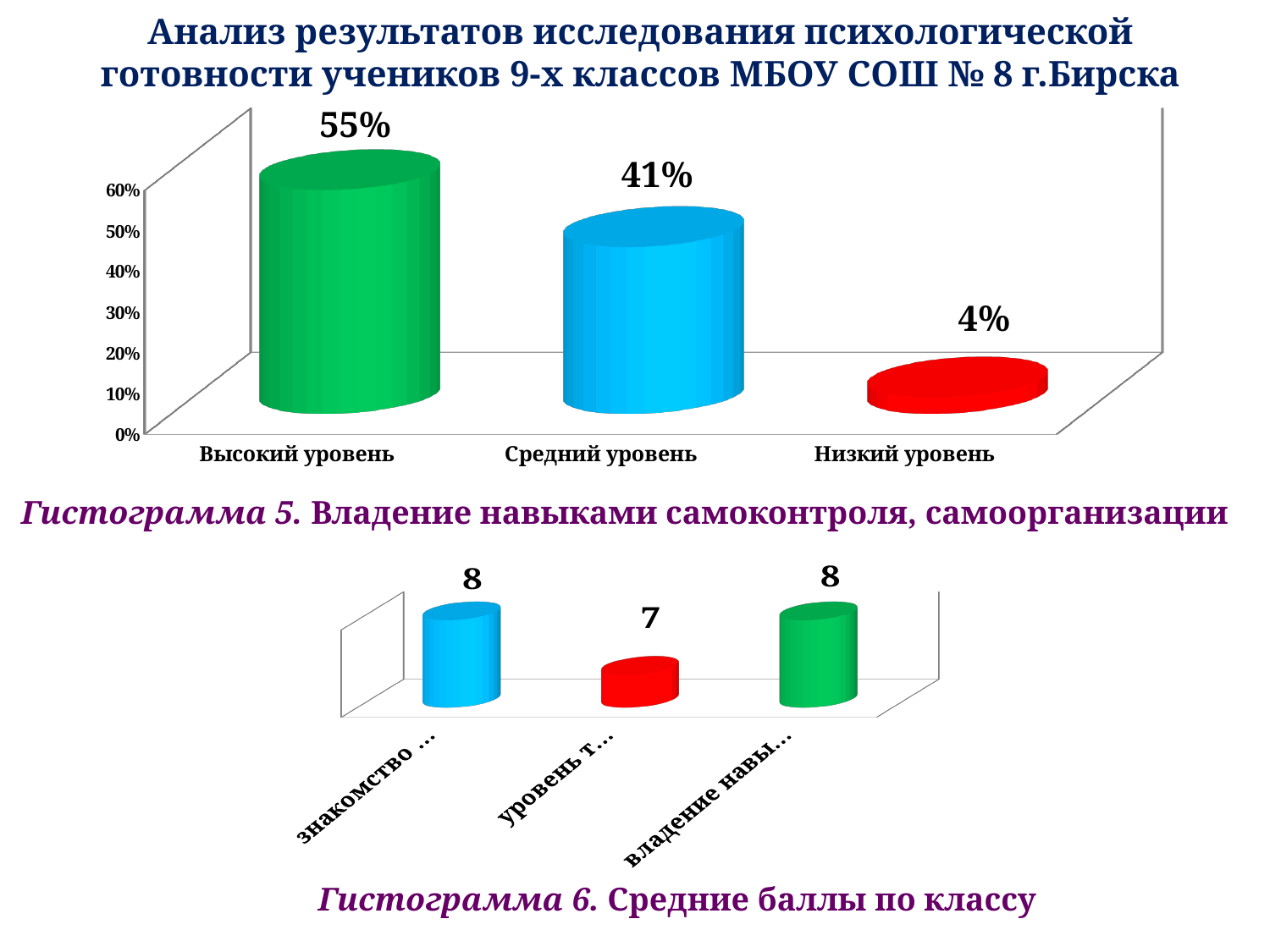
In the bottom chart (Гистограмма 6), what is the value of the middle (red) bar? 7 In the top chart (Гистограмма 5), how many categories are shown? 3 In the bottom chart (Гистограмма 6), how many bars are shown? 3 In the bottom chart (Гистограмма 6), what is the value of the first (blue) bar? 8 In the top chart (Гистограмма 5), which category has the lowest value? Низкий уровень In the top chart (Гистограмма 5), what is the value for Высокий уровень? 55% In the top chart (Гистограмма 5), what is the difference between Высокий уровень and Средний уровень? 14% What kind of chart is the top chart (Гистограмма 5)? bar chart In the top chart (Гистограмма 5), what is the value for Средний уровень? 41% In the top chart (Гистограмма 5), which category has the highest value? Высокий уровень In the top chart (Гистограмма 5), what is the value for Низкий уровень? 4% In the top chart (Гистограмма 5), do the values rise or fall from left to right? fall